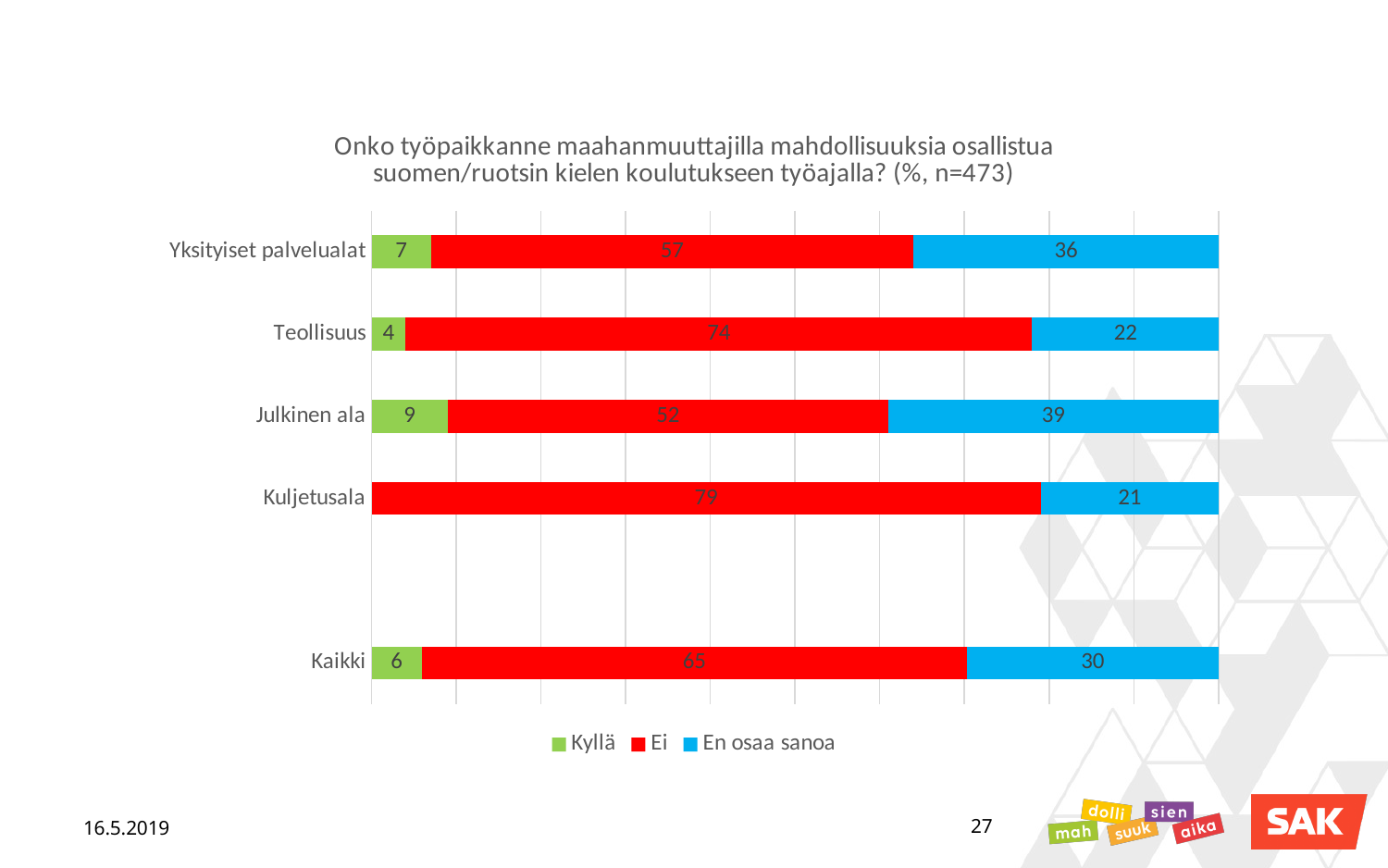
Which category has the lowest "En osaa sanoa" value? Kuljetusala What kind of chart is shown on the slide? Stacked bar chart Which category has the highest "Ei" value? Kuljetusala What is the "Ei" value for Teollisuus? 74 How many categories are shown on the y axis? 5 What is the "Kyllä" value for Yksityiset palvelualat? 7 How many series does the legend list? 3 What is the total of the stacked bar for Kaikki? 101 Which is larger: the "En osaa sanoa" value for Yksityiset palvelualat or for Teollisuus? Yksityiset palvelualat Which category has the highest "Kyllä" value? Julkinen ala What is the "En osaa sanoa" value for Julkinen ala? 39 What is the difference between the "Ei" values for Kuljetusala and Julkinen ala? 27